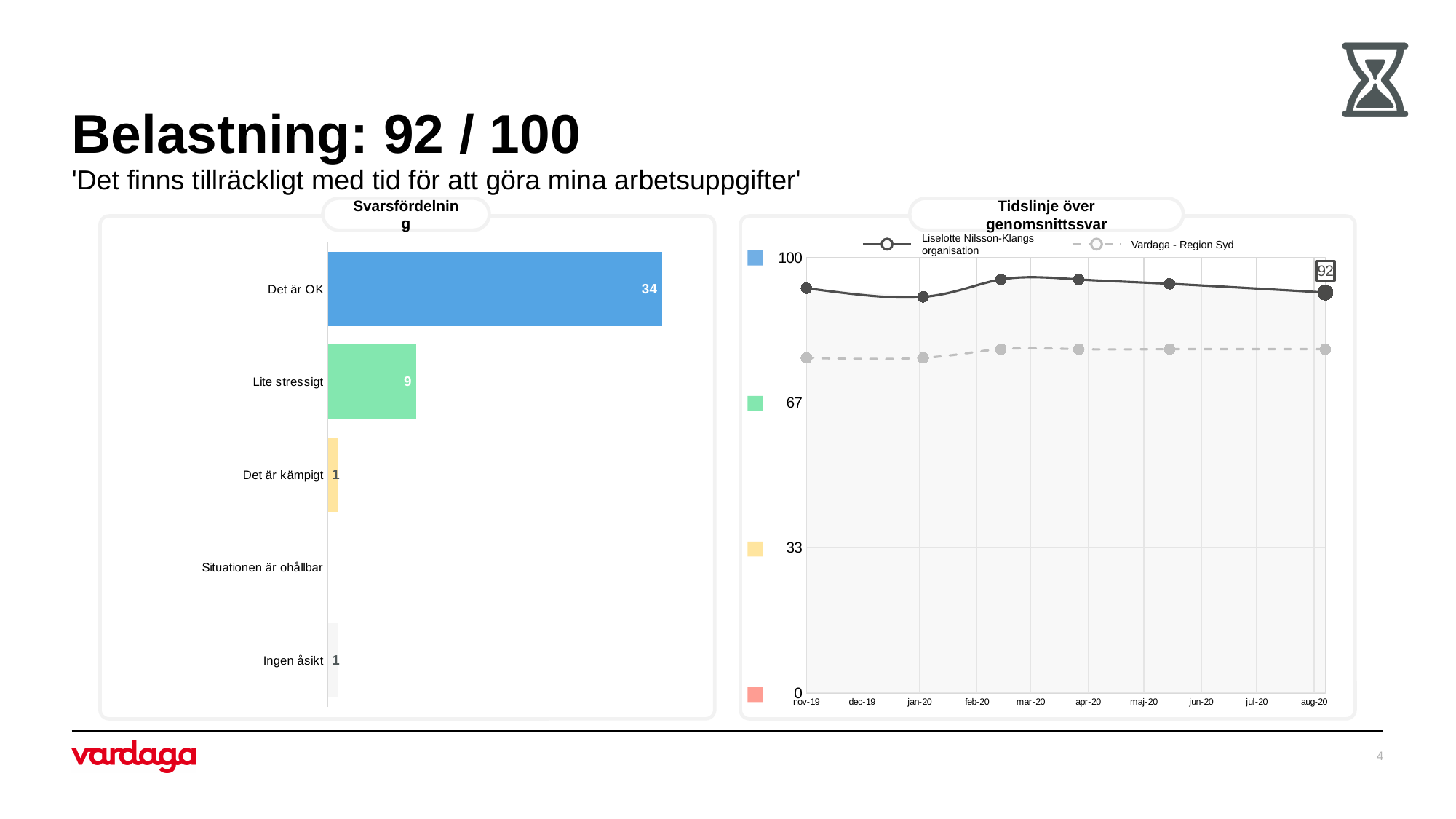
In the Svarsfördelning chart, what is the value for 'Lite stressigt'? 9 How many series does the legend of the Tidslinje över genomsnittssvar chart list? 2 In the Svarsfördelning chart, which is larger: 'Lite stressigt' or 'Det är kämpigt'? Lite stressigt What kind of chart is the Svarsfördelning chart? Bar chart In the Tidslinje över genomsnittssvar chart, what is the value for 'Liselotte Nilsson-Klangs organisation' at aug-20? 92 In the Svarsfördelning chart, which category has the highest value? Det är OK In the Tidslinje över genomsnittssvar chart, is the value for 'Vardaga - Region Syd' at aug-20 greater or less than 67? greater What kind of chart is the Tidslinje över genomsnittssvar chart? Line chart In the Tidslinje över genomsnittssvar chart, which series is drawn with a dashed line? Vardaga - Region Syd In the Svarsfördelning chart, what is the difference between 'Det är OK' and 'Lite stressigt'? 25 In the Svarsfördelning chart, what is the value for 'Det är OK'? 34 How many categories are shown in the Svarsfördelning chart? 5